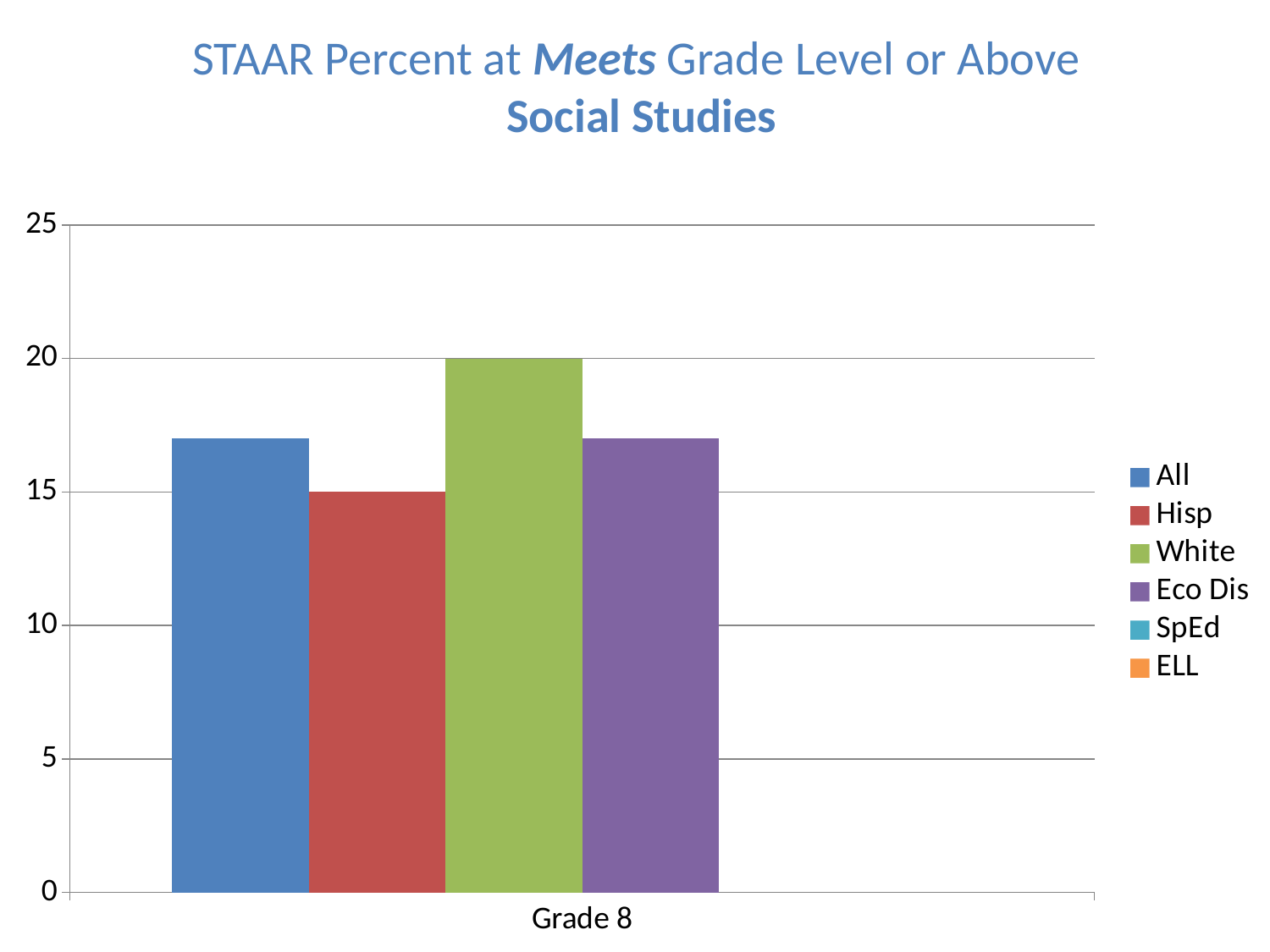
What is the value for the White series for Grade 8? 20 Is the value for All for Grade 8 greater or less than 15? greater Which is larger for Grade 8, the All value or the Hisp value? All What is the value for the Hisp series for Grade 8? 15 Is the value for Eco Dis for Grade 8 greater or less than 20? less Among the bars shown for Grade 8, which series has the shortest bar? Hisp Which series has the tallest bar for Grade 8? White What is the difference between the White and Hisp values for Grade 8? 5 Which subject is named in the chart title? Social Studies How many categories are shown on the x axis? 1 What kind of chart is shown on the slide? Bar chart How many series does the legend list? 6